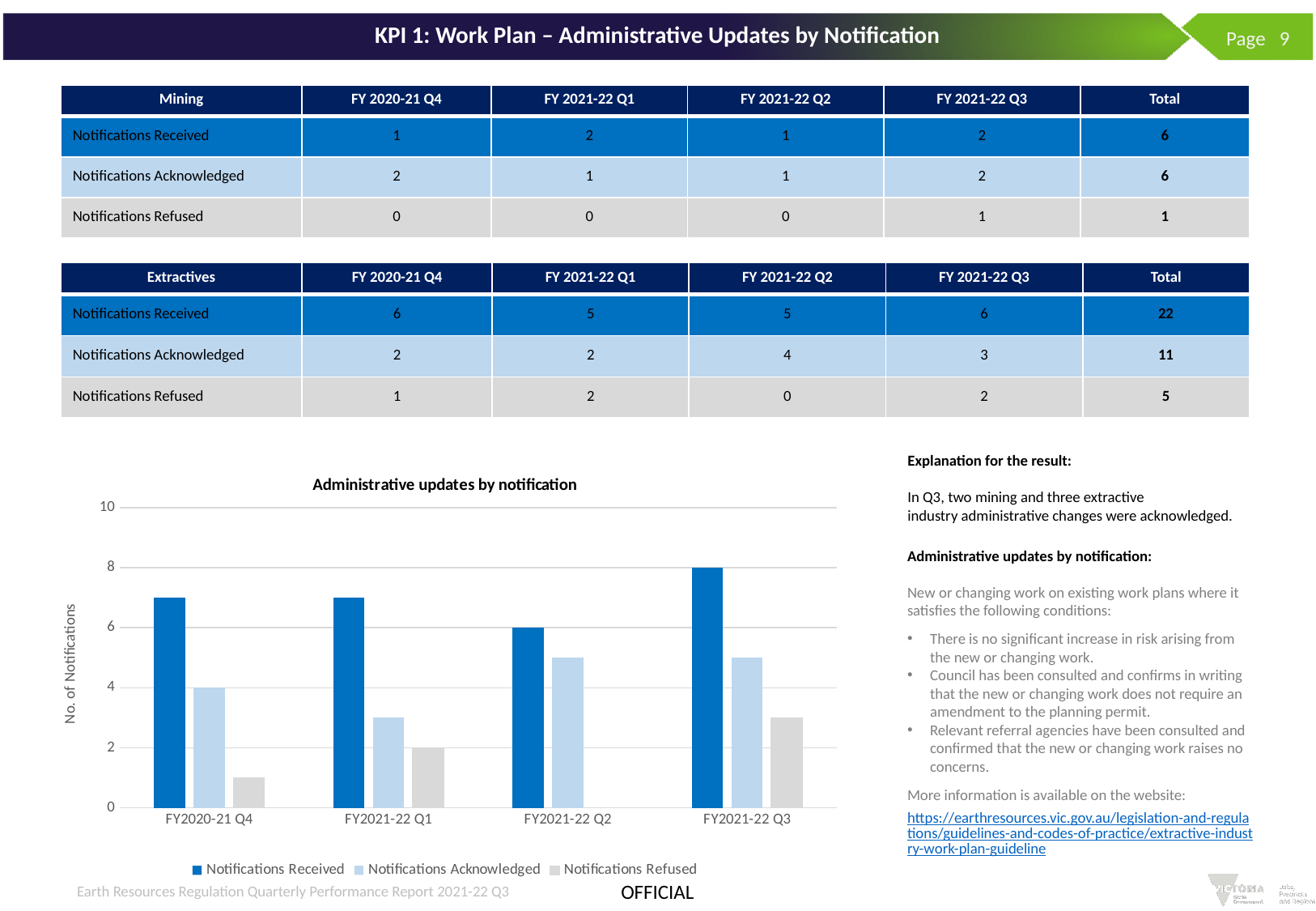
What is the value for Notifications Refused in FY2021-22 Q2? 0 What kind of chart is shown on the slide? bar chart Which quarter has the lowest value for Notifications Refused? FY2021-22 Q2 What is the value for Notifications Acknowledged in FY2020-21 Q4? 4 What is the value for Notifications Received in FY2021-22 Q2? 6 What is the title of the chart? Administrative updates by notification What is the y-axis label of the chart? No. of Notifications Is the value for Notifications Received in FY2020-21 Q4 greater or less than 6? greater How many quarters are shown on the x axis of the chart? 4 Which quarter has the highest value for Notifications Received? FY2021-22 Q3 How many series does the chart legend list? 3 What is the value for Notifications Received in FY2021-22 Q3? 8